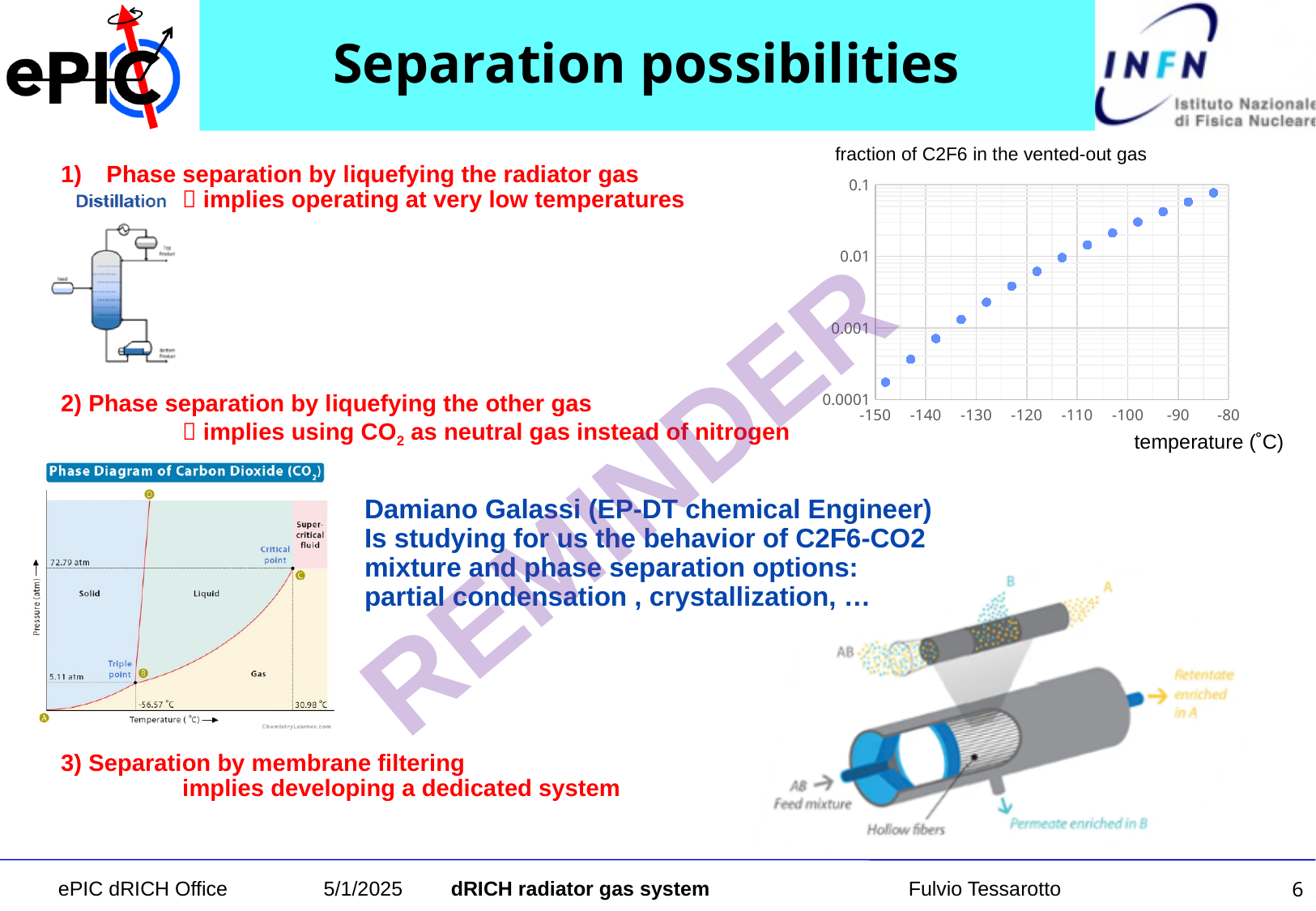
In the 'fraction of C2F6 in the vented-out gas' chart, is the fraction larger at -100 °C or at -130 °C? -100 °C In the 'fraction of C2F6 in the vented-out gas' chart, is the fraction larger at -150 °C or at -80 °C? -80 °C In the 'fraction of C2F6 in the vented-out gas' chart, is the fraction at -120 °C greater or less than 0.001? greater In the 'fraction of C2F6 in the vented-out gas' chart, is the fraction at -120 °C greater or less than 0.01? less What is the x-axis label of the 'fraction of C2F6 in the vented-out gas' chart? temperature (°C) In the 'fraction of C2F6 in the vented-out gas' chart, is the fraction at -150 °C greater or less than 0.001? less What are the lowest and highest values shown on the y-axis of the 'fraction of C2F6 in the vented-out gas' chart? 0.0001 and 0.1 What kind of chart is the 'fraction of C2F6 in the vented-out gas' plot? scatter plot In the 'fraction of C2F6 in the vented-out gas' chart, does the fraction rise or fall as temperature increases from -150 to -80 °C? rise